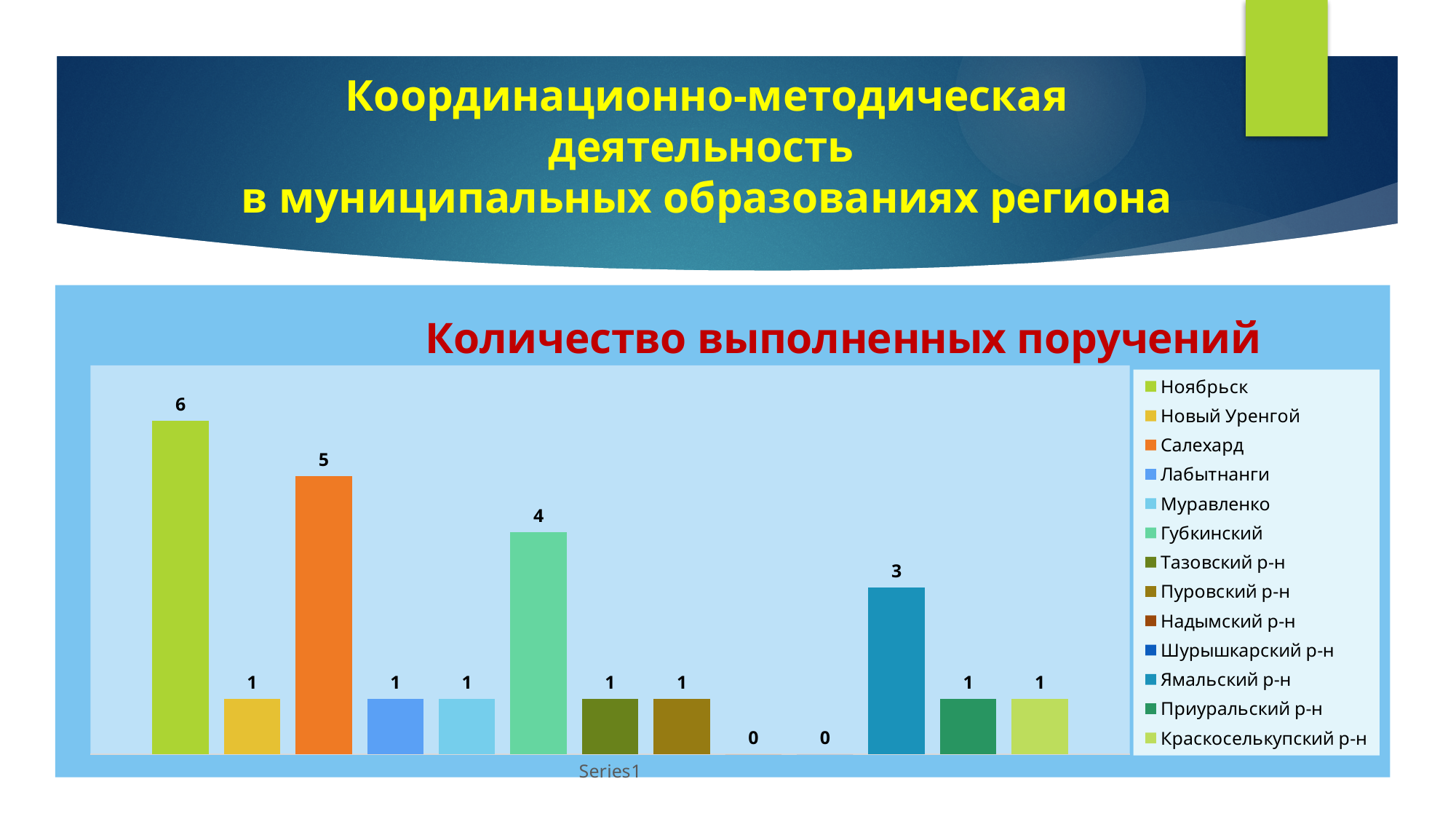
How many categories have a value of 0? 2 How many entries does the legend list? 13 What is the difference between the values for Ноябрьск and Салехард? 1 What is the value for Губкинский? 4 What kind of chart is shown on the slide? bar chart What is the value for Салехард? 5 What is the title of the chart? Количество выполненных поручений What is the value for Надымский р-н? 0 What is the value for Ноябрьск? 6 What is the value for Ямальский р-н? 3 Which category has the highest value? Ноябрьск Which is larger, the value for Губкинский or the value for Ямальский р-н? Губкинский